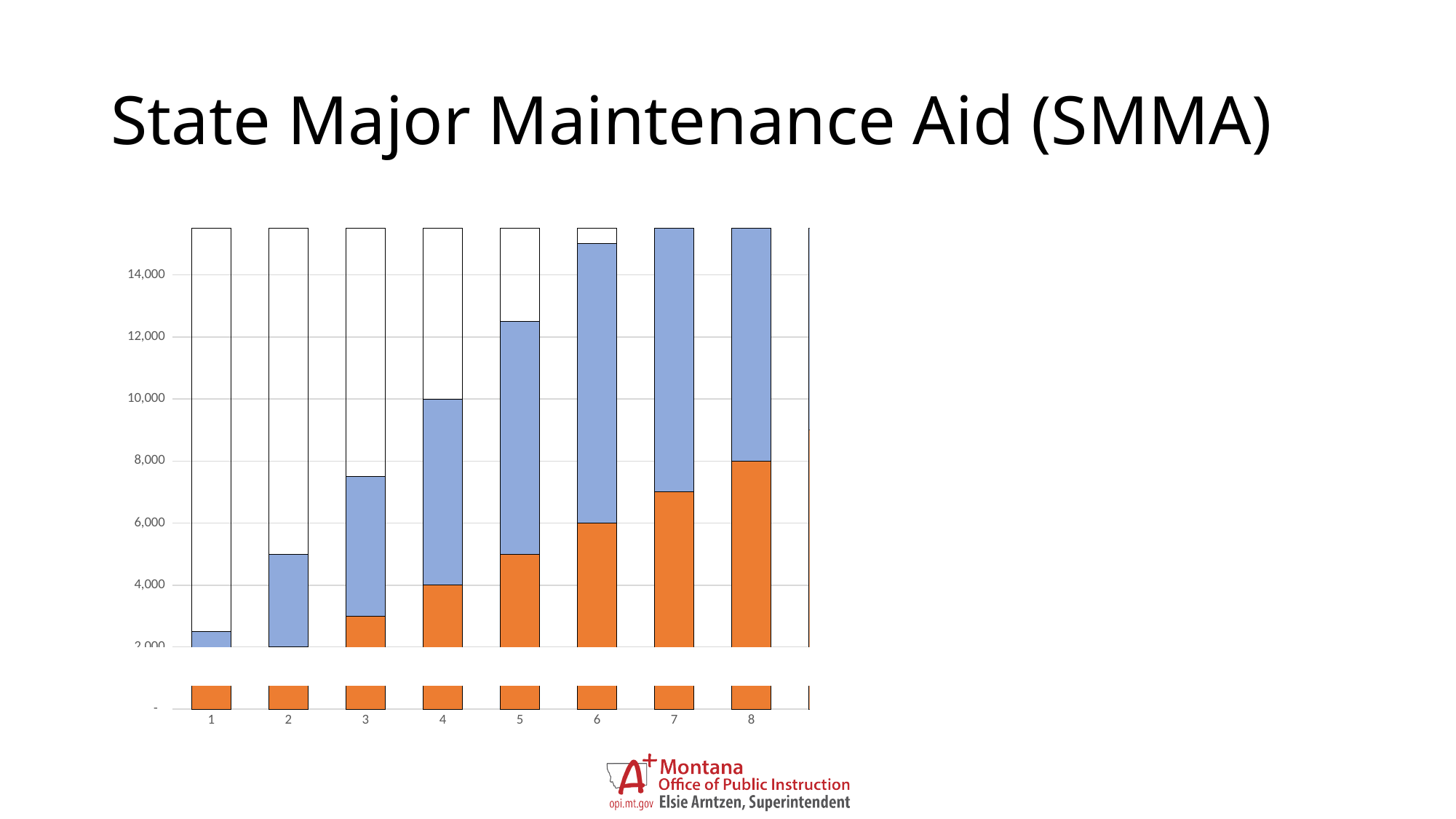
Is the top of the blue segment for category 2 greater or less than 6,000? less At which axis value does the top of the orange segment for category 4 land? 4,000 Is the top of the orange segment for category 8 greater or less than 6,000? greater Do the orange segments rise or fall from category 1 to category 8? rise Is the orange segment for category 7 larger or smaller than the orange segment for category 3? larger How many labeled categories are shown on the x axis of the chart? 8 Is the top of the blue segment for category 6 greater or less than 14,000? greater Which category has the smallest orange segment? 1 What kind of chart is shown on the slide? stacked bar chart Which category has the largest orange segment? 8 At which axis value does the top of the blue segment for category 4 land? 10,000